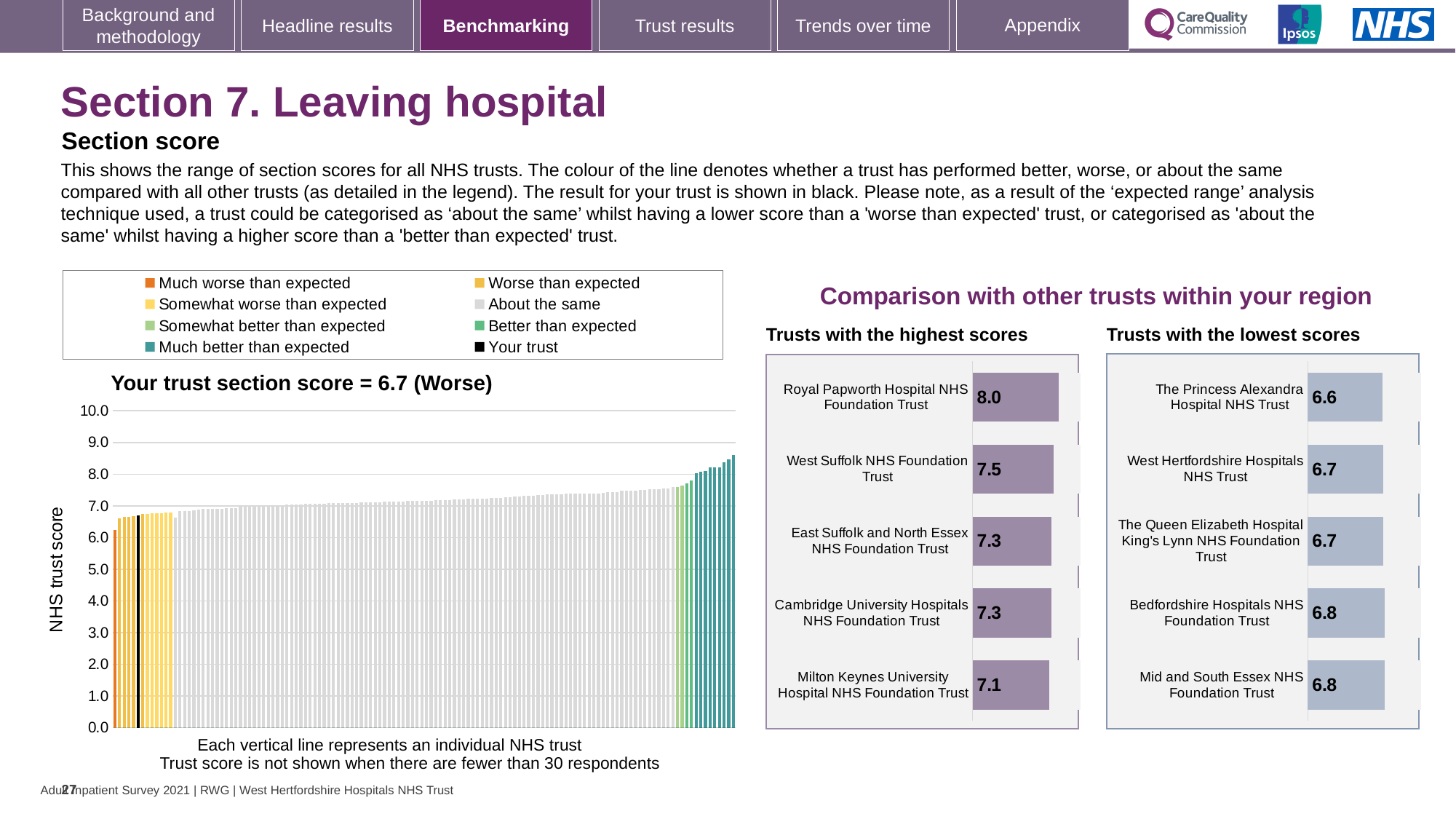
In the 'Trusts with the highest scores' chart, which has the larger score: West Suffolk NHS Foundation Trust or East Suffolk and North Essex NHS Foundation Trust? West Suffolk NHS Foundation Trust In the 'Trusts with the lowest scores' chart, which trust has the lowest score? The Princess Alexandra Hospital NHS Trust In the 'Trusts with the highest scores' chart, which trust has the highest score? Royal Papworth Hospital NHS Foundation Trust In the 'Trusts with the highest scores' chart, what is the score for Royal Papworth Hospital NHS Foundation Trust? 8.0 In the 'Trusts with the lowest scores' chart, what is the difference between the scores of Mid and South Essex NHS Foundation Trust and The Princess Alexandra Hospital NHS Trust? 0.2 How many entries does the legend above the main chart on the left list? 8 According to the title of the main chart on the left, what is your trust's section score? 6.7 (Worse) How many trusts are shown in the 'Trusts with the highest scores' chart? 5 In the 'Trusts with the lowest scores' chart, what is the score for Bedfordshire Hospitals NHS Foundation Trust? 6.8 What kind of chart is the main chart on the left showing NHS trust scores? Bar chart In the 'Trusts with the highest scores' chart, what is the score for Milton Keynes University Hospital NHS Foundation Trust? 7.1 In the 'Trusts with the highest scores' chart, what is the difference between the scores of Royal Papworth Hospital NHS Foundation Trust and West Suffolk NHS Foundation Trust? 0.5